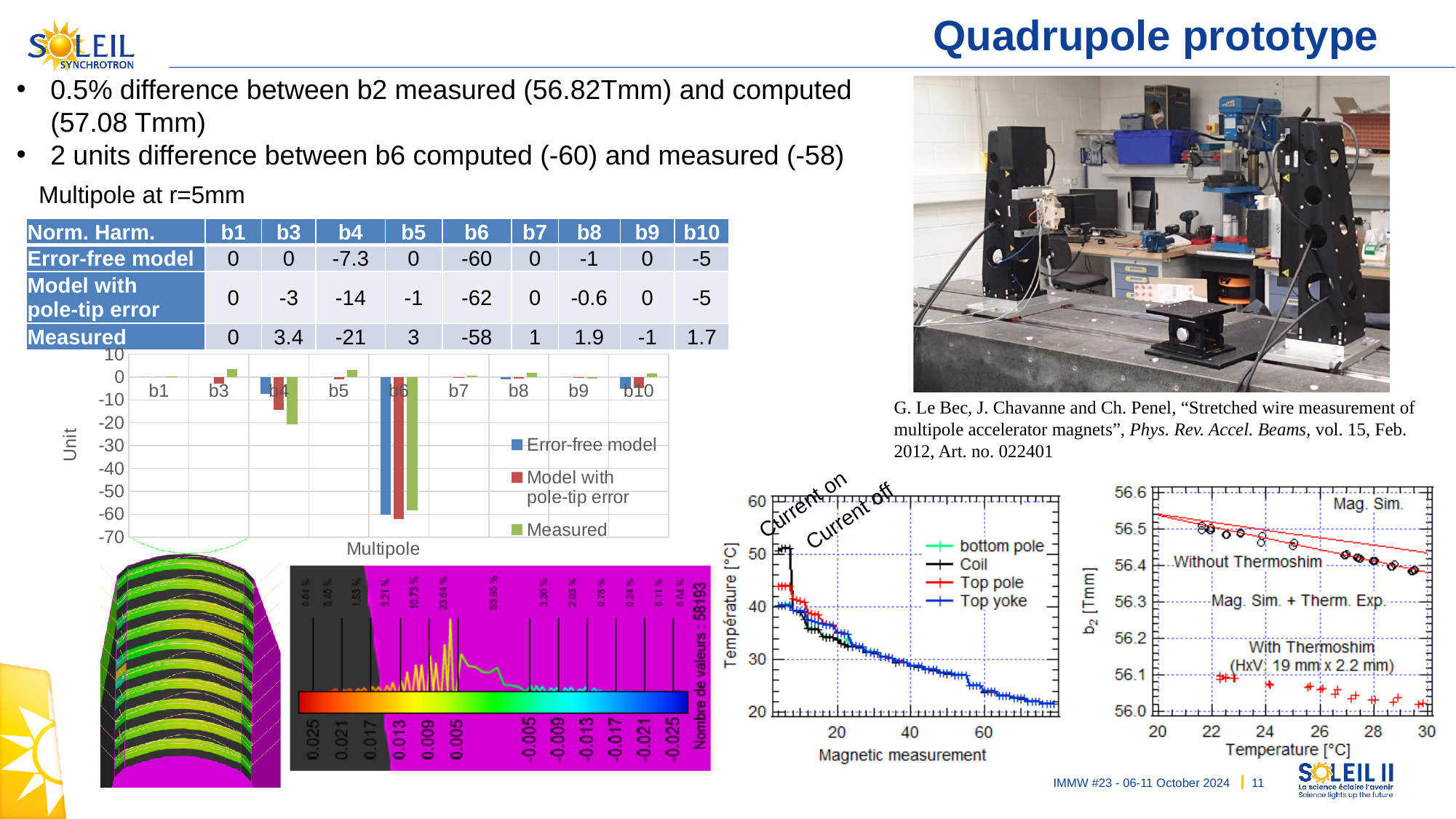
In the 'Multipole' bar chart, what is the value of the 'Model with pole-tip error' series for b6? -62 How many series does the legend of the 'Temperature vs Magnetic measurement' line chart at the bottom of the slide list? 4 In the 'Multipole' bar chart, what is the difference between the Error-free model value (-60) and the Measured value (-58) for b6? 2 What type of chart is the 'Multipole' chart on the left of the slide? bar chart In the 'Multipole' bar chart, which multipole has the lowest value for the Measured series? b6 How many multipole categories are shown on the x axis of the 'Multipole' bar chart? 9 In the 'Multipole' bar chart, what is the Measured value for b4? -21 In the 'Multipole' bar chart, what is the label of the y axis? Unit How many series does the legend of the 'Multipole' bar chart list? 3 In the 'Multipole' bar chart, is the Measured value for b6 greater or less than -50? less In the 'Multipole' bar chart, which is lower for b4: the Error-free model value or the Measured value? Measured In the 'b2 vs Temperature' chart at the bottom right, are the 'With Thermoshim' values greater or less than 56.2 Tmm? less